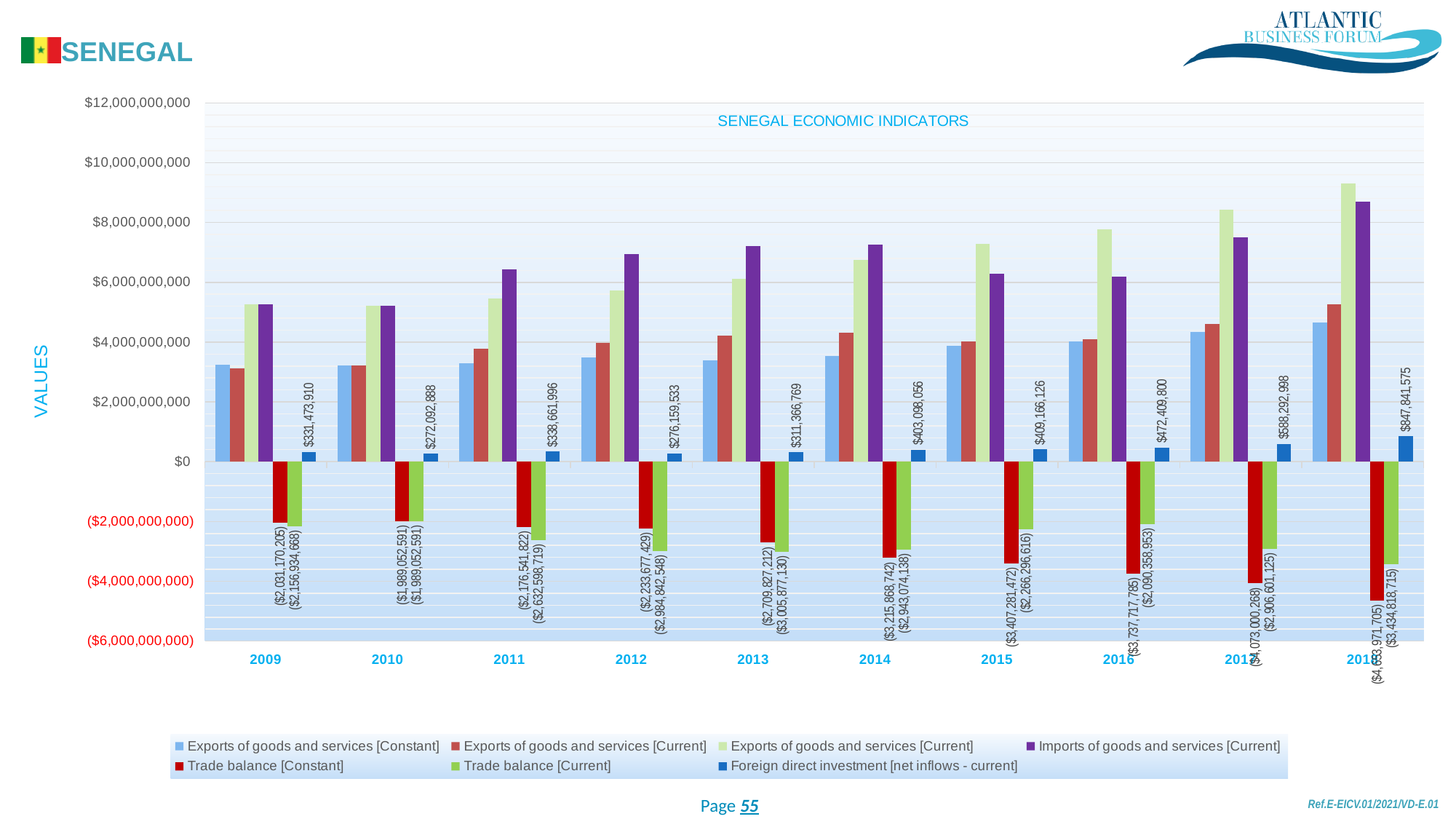
How many years are shown on the x axis? 10 In which year is Foreign direct investment [net inflows - current] highest? 2018 Which is larger: Imports of goods and services [Current] in 2017 or in 2016? 2017 In which year is Foreign direct investment [net inflows - current] lowest? 2010 Is the value of Exports of goods and services [Constant] for 2009 greater or less than $4,000,000,000? less What is the value of Foreign direct investment [net inflows - current] for 2018? $847,841,575 Is the value of Imports of goods and services [Current] for 2018 greater or less than $8,000,000,000? greater What is the Trade balance [Current] value for 2012? ($2,984,842,548) How many series does the legend list? 7 What is the Trade balance [Constant] value for 2014? ($3,215,868,742) What is the value of Foreign direct investment [net inflows - current] for 2010? $272,092,888 What is the difference between Foreign direct investment [net inflows - current] in 2018 and in 2017? $259,548,577